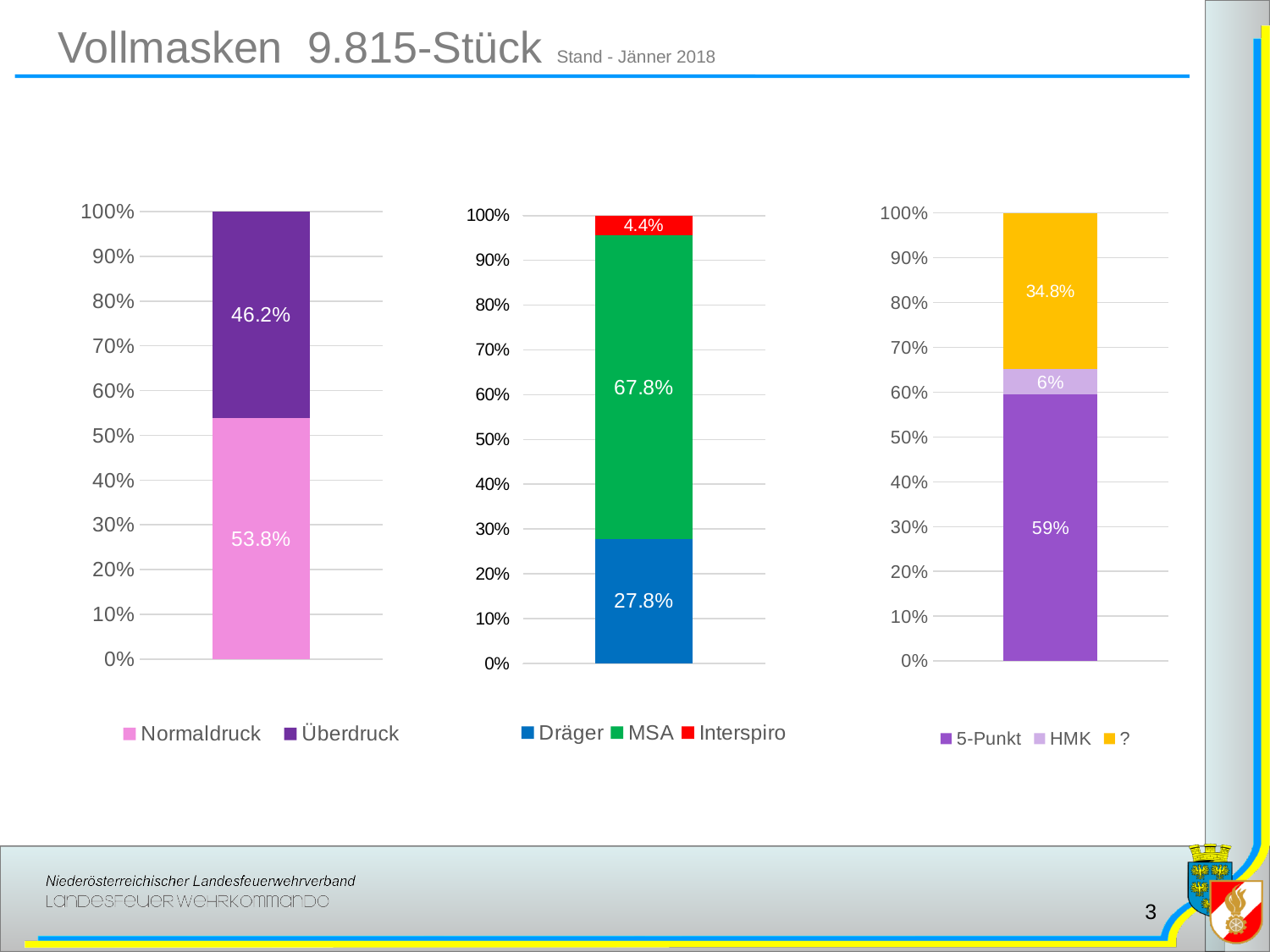
In the middle chart, what is the value for MSA? 67.8% In the left chart, what is the value for Überdruck? 46.2% In the left chart, which is larger, Normaldruck or Überdruck? Normaldruck In the middle chart, what is the difference between the MSA and Dräger values? 40% In the right chart, which series has the smallest share? HMK How many series does the legend of the middle chart list? 3 In the left chart, what is the value for Normaldruck? 53.8% In the right chart, what is the value for HMK? 6% In the middle chart, which series has the largest share? MSA In the right chart, what is the value for 5-Punkt? 59% In the middle chart, what is the value for Interspiro? 4.4% What kind of chart is the right chart? Stacked bar chart